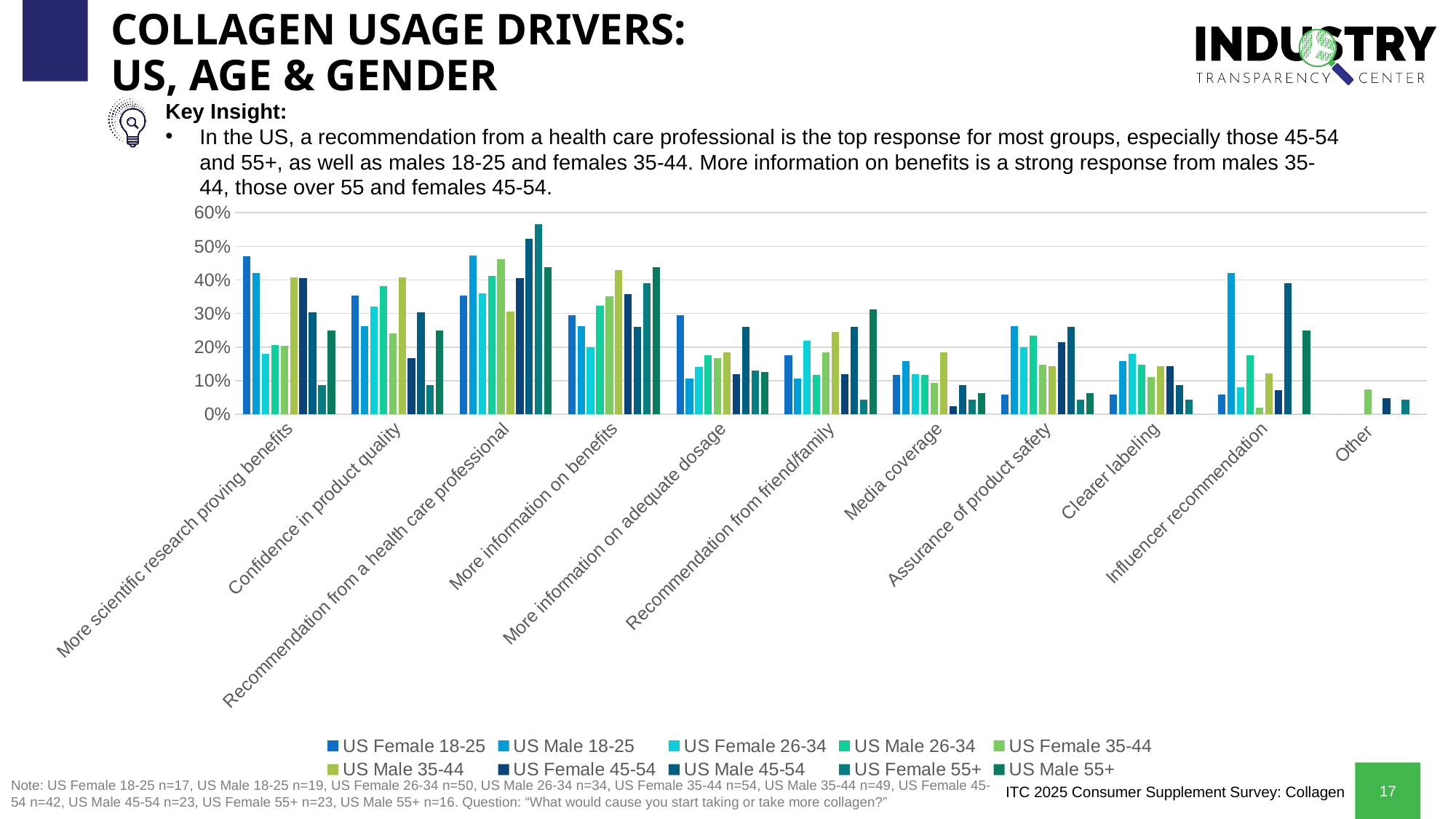
Is the value for US Male 45-54 in the 'Recommendation from a health care professional' category greater or less than 50%? greater Which series has the highest value in the 'Other' category? US Female 35-44 Is the value for US Female 18-25 in the 'More scientific research proving benefits' category greater or less than 40%? greater How many series does the chart's legend list? 10 Is the value for US Male 18-25 in the 'Influencer recommendation' category greater or less than 30%? greater How many categories are shown along the x axis of the chart? 11 In the 'More information on benefits' category, which is larger: the value for US Male 35-44 or US Female 35-44? US Male 35-44 What kind of chart is shown on the slide? bar chart Which category is listed last on the x axis of the chart? Other Which series has the highest value in the 'Recommendation from a health care professional' category? US Female 55+